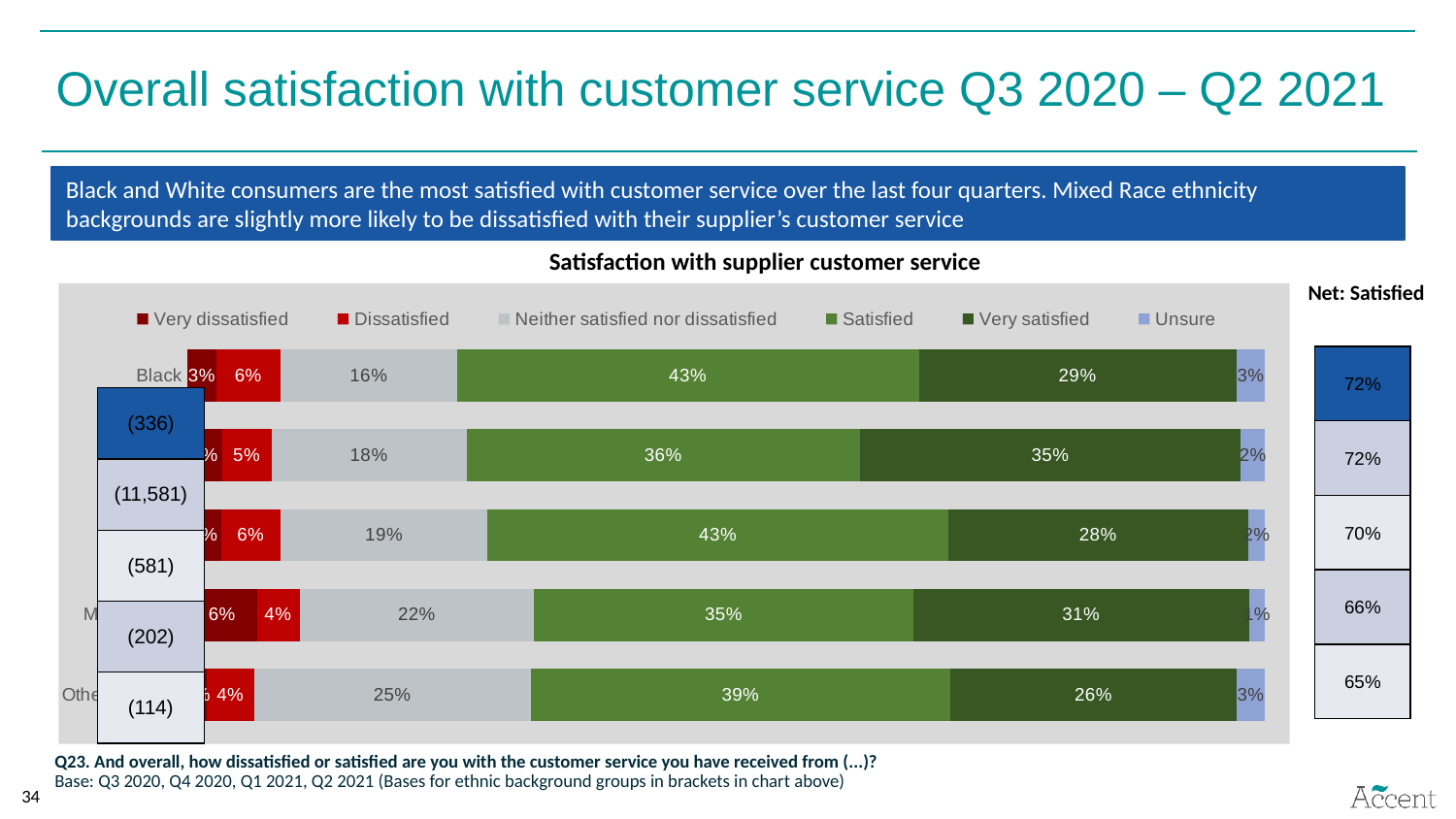
What type of chart is shown on the slide? Stacked bar chart What is the Very dissatisfied value for the Black bar? 3% What percentage of Black consumers are Very satisfied with supplier customer service? 29% For the Black bar, which is larger: the Satisfied segment or the Very satisfied segment? Satisfied For the Black bar, what is the difference between the Satisfied and Very satisfied percentages? 14 percentage points What percentage of Black consumers are Satisfied with supplier customer service? 43% What is the Dissatisfied value for the Black bar? 6% What is the Net: Satisfied figure shown for the Black group? 72% What is the Neither satisfied nor dissatisfied value for the Black bar? 16% How many series does the chart legend list? 6 What is the Unsure value for the Black bar? 3% Which response category makes up the largest segment of the Black bar? Satisfied